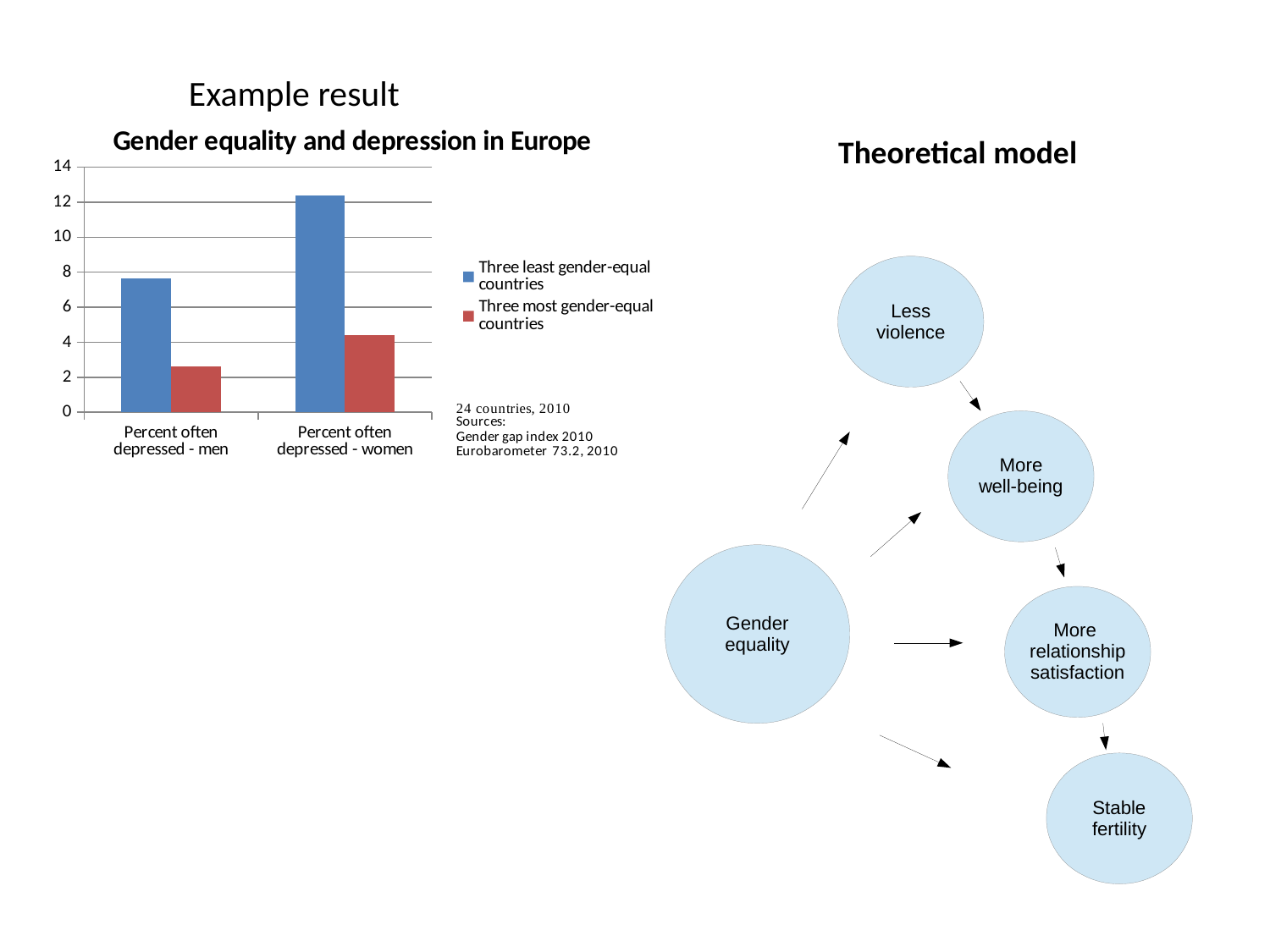
How many series does the legend list? 2 How many categories are shown on the x axis? 2 Which category has the highest bar for the three least gender-equal countries? Percent often depressed - women Is the value for 'Percent often depressed - men' in the three least gender-equal countries greater or less than 6? greater Is the value for 'Percent often depressed - women' in the three most gender-equal countries greater or less than 6? less For 'Percent often depressed - women', which series has the larger value: three least gender-equal countries or three most gender-equal countries? Three least gender-equal countries What is the title of the chart? Gender equality and depression in Europe Is the value for 'Percent often depressed - men' in the three most gender-equal countries greater or less than 4? less Which category has the lowest bar for the three most gender-equal countries? Percent often depressed - men What kind of chart is shown? bar chart Which series is shown in blue? Three least gender-equal countries